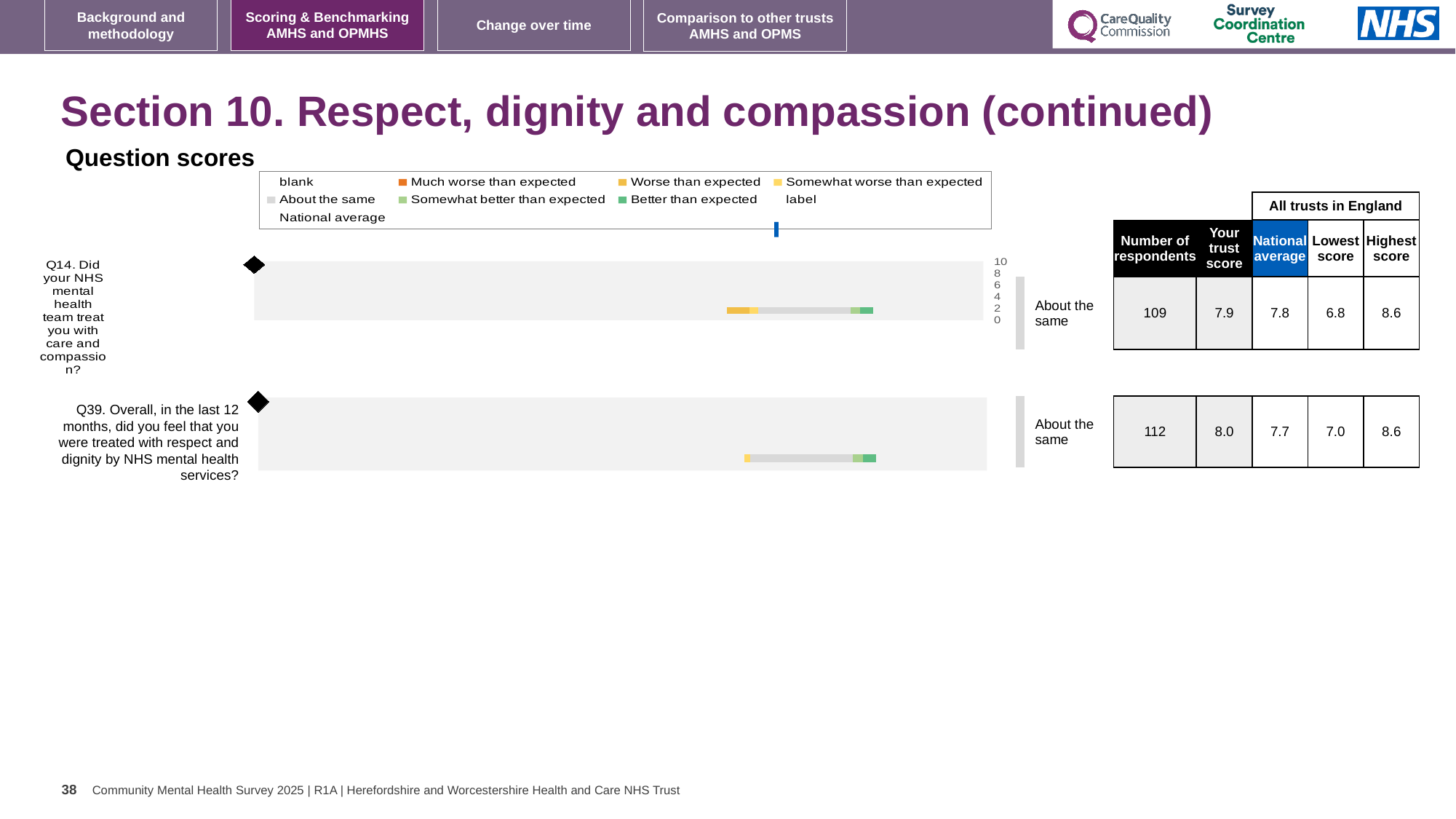
What is the difference between the highest and lowest scores for Q14? 1.8 What is the trust score for Q14 (care and compassion)? 7.9 Which question has more respondents? Q39 What is the lowest score among all trusts in England for Q39? 7.0 What benchmark category is shown for Q39? About the same Which question has the higher trust score, Q14 or Q39? Q39 What kind of chart is used to show the question scores on this slide? Bar chart How many questions are plotted in the question scores chart? 2 What is the highest score among all trusts in England for Q14? 8.6 What is the national average for Q39 (treated with respect and dignity)? 7.7 How many respondents answered Q14? 109 What is the difference between the trust score and the national average for Q39? 0.3